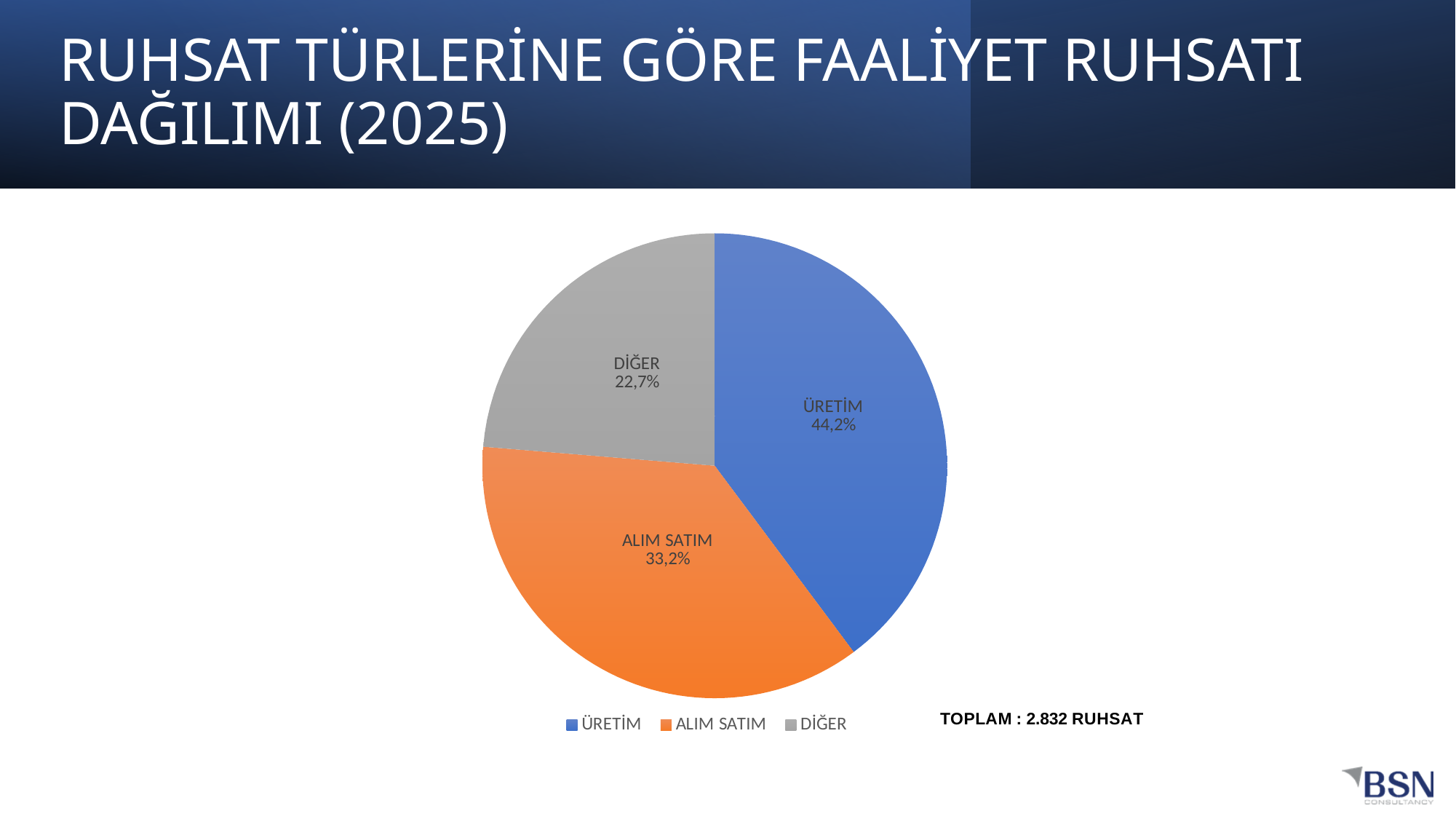
Which category has the largest slice of the pie? ÜRETİM What is the difference in percentage points between the ALIM SATIM and DİĞER slices? 10,5% What share of the pie does DİĞER represent? 22,7% Which colour represents ALIM SATIM in the legend? Orange What total number of licences (RUHSAT) is stated next to the chart? 2.832 What share of the pie does ÜRETİM represent? 44,2% Which slice is larger, ALIM SATIM or DİĞER? ALIM SATIM How many slices does the pie chart have? 3 What is the difference in percentage points between the ÜRETİM and ALIM SATIM slices? 11,0% Which category has the smallest slice of the pie? DİĞER What share of the pie does ALIM SATIM represent? 33,2% What kind of chart is shown on the slide? Pie chart